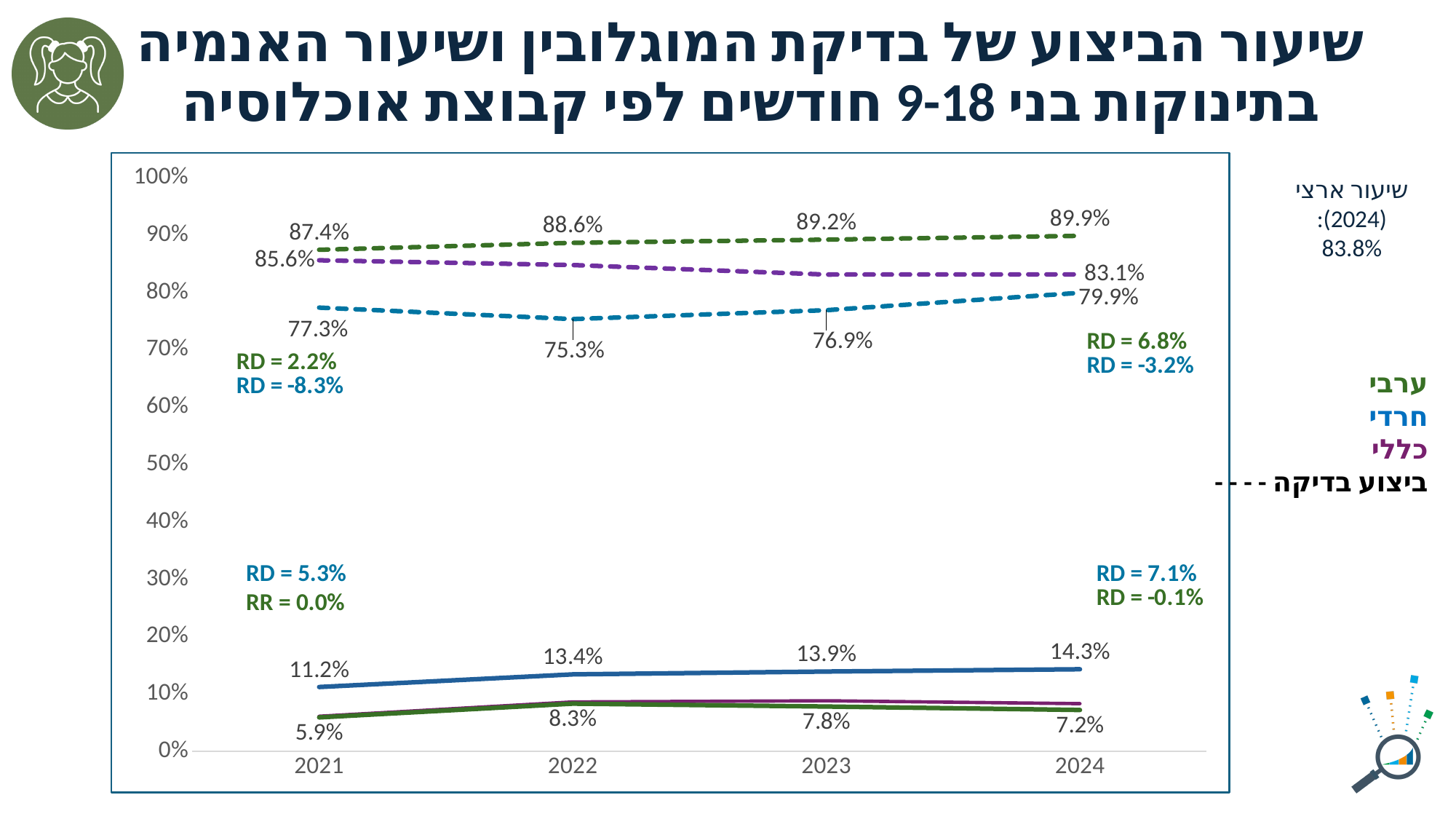
What is the test performance rate (dashed line) for the ערבי (Arab) group in 2024? 89.9% How many years are shown on the x axis? 4 Which group has the lowest test performance rate (dashed line) in 2021? חרדי What is the national rate (שיעור ארצי) for 2024 shown on the slide? 83.8% What is the anemia rate (solid line) for the חרדי (Haredi) group in 2021? 11.2% What is the test performance rate (dashed line) for the כללי (General) group in 2024? 83.1% What is the test performance rate (dashed line) for the חרדי (Haredi) group in 2022? 75.3% Which group has the highest test performance rate (dashed line) in 2024? ערבי What is the anemia rate (solid line) for the ערבי (Arab) group in 2023? 7.8% What is the difference between the ערבי (Arab) and חרדי (Haredi) test performance rates in 2021? 10.1% Does the test performance rate for the ערבי (Arab) group rise or fall from 2021 to 2024? rise What kind of chart is shown on the slide? line chart